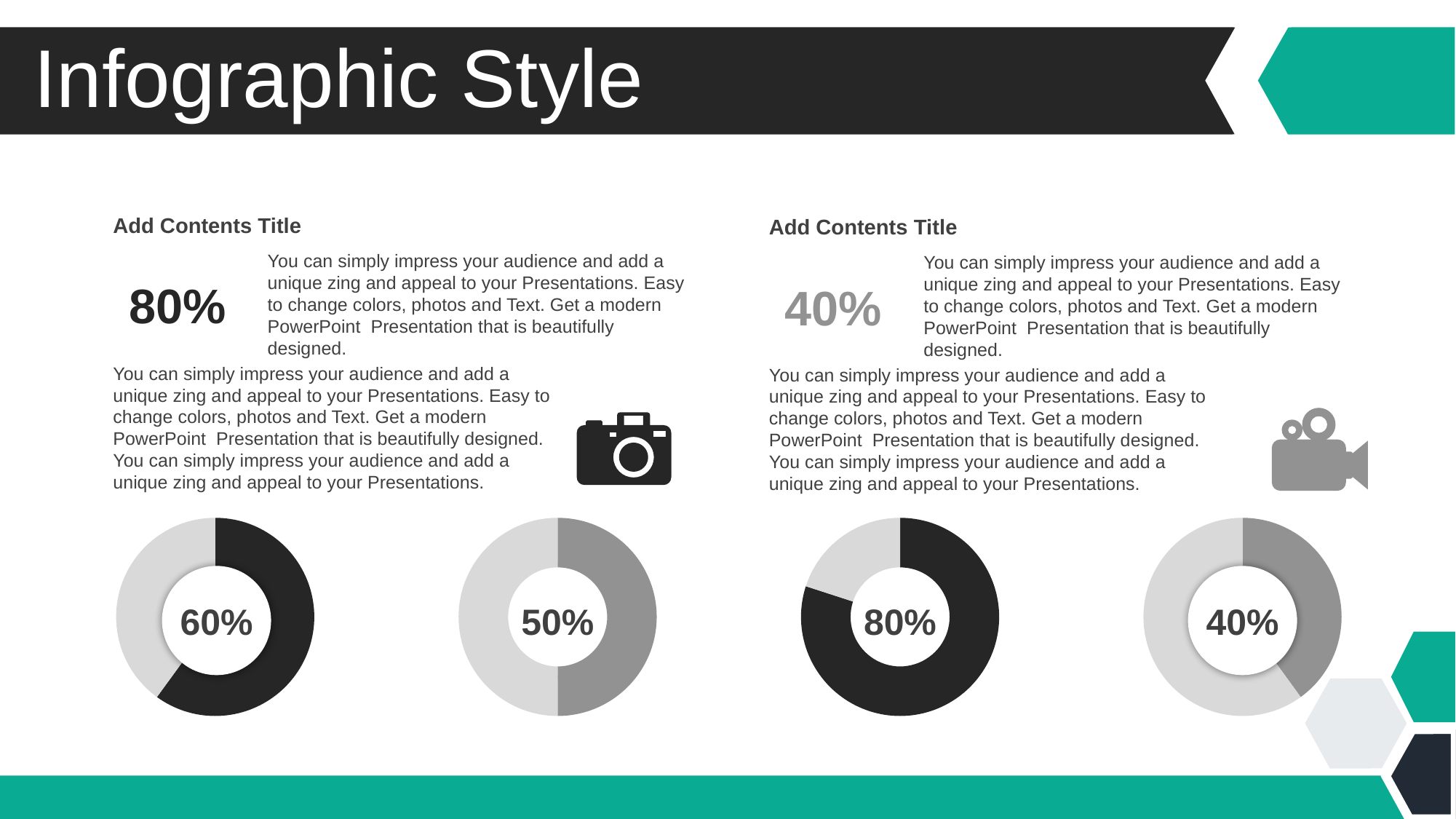
What kind of chart is the leftmost chart on the slide? donut chart What percentage is shown in the center of the leftmost donut chart? 60% Which donut chart shows the lowest percentage? the rightmost (40%) How many donut charts are shown on the slide? 4 What percentage is shown in the center of the second donut chart from the left? 50% Which donut chart shows the highest percentage? the third from the left (80%) What share of the rightmost donut chart is filled with the darker grey segment? 40% What is the difference between the percentage in the third donut chart from the left and the percentage in the rightmost donut chart? 40% What percentage is shown in the center of the third donut chart from the left? 80% What colour is the filled segment of the third donut chart from the left? black What percentage is shown in the center of the rightmost donut chart? 40% Which shows a larger percentage, the leftmost donut chart or the second donut chart from the left? the leftmost (60%)